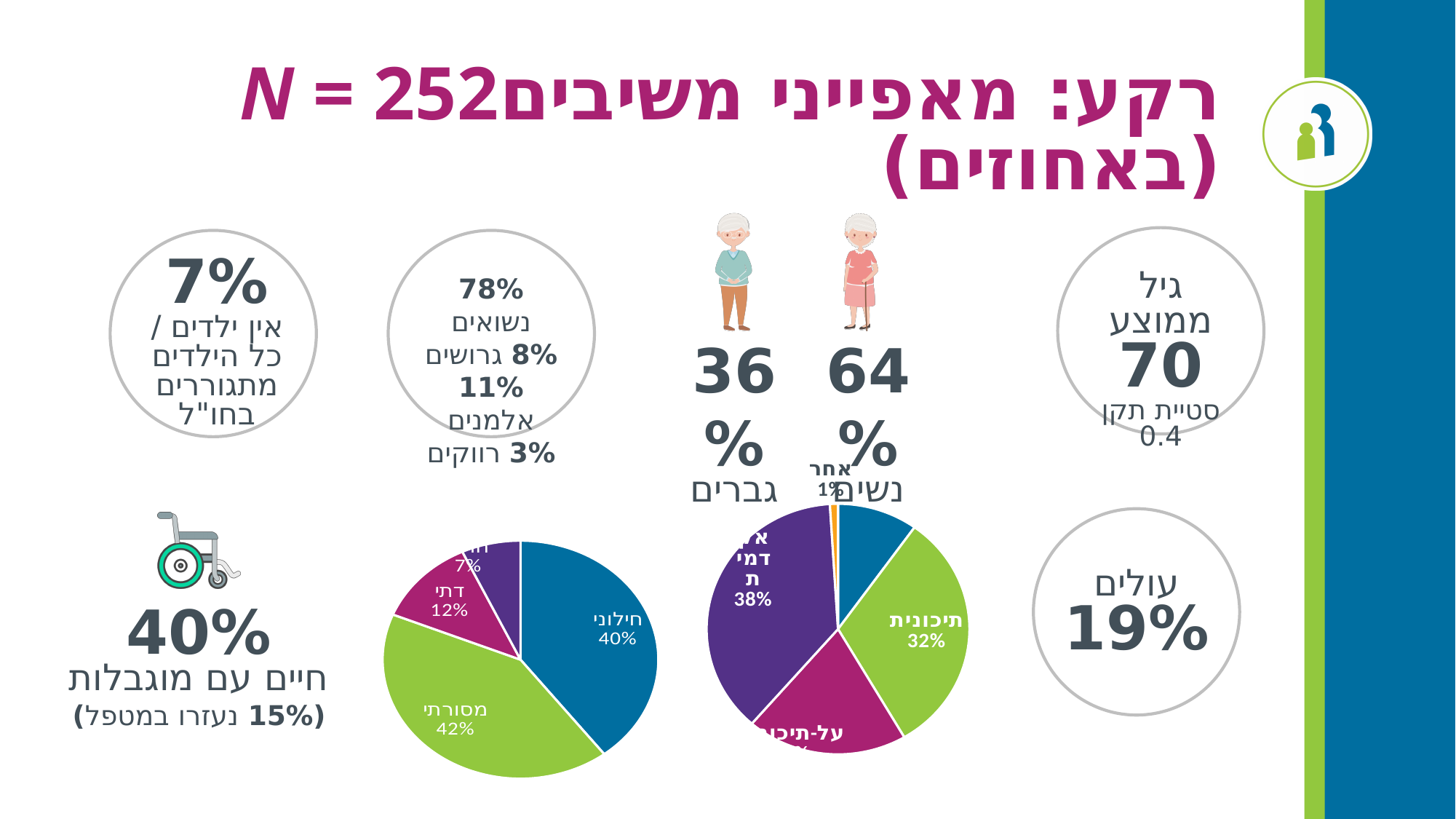
In the left pie chart, what is the difference between the values for חילוני and דתי? 28% In the left pie chart, how many slices are there? 4 In the left pie chart, what is the value for מסורתי? 42% In the left pie chart, which is larger, מסורתי or דתי? מסורתי In the right pie chart, what is the value for אחר? 1% What kind of chart is the left chart on the slide? pie chart In the right pie chart, which category has the smallest slice? אחר In the right pie chart, what is the value for תיכונית? 32% In the left pie chart, what is the difference between the values for מסורתי and חילוני? 2% In the left pie chart, what is the value for חילוני? 40% In the left pie chart, which category has the largest slice? מסורתי In the left pie chart, what is the value for דתי? 12%